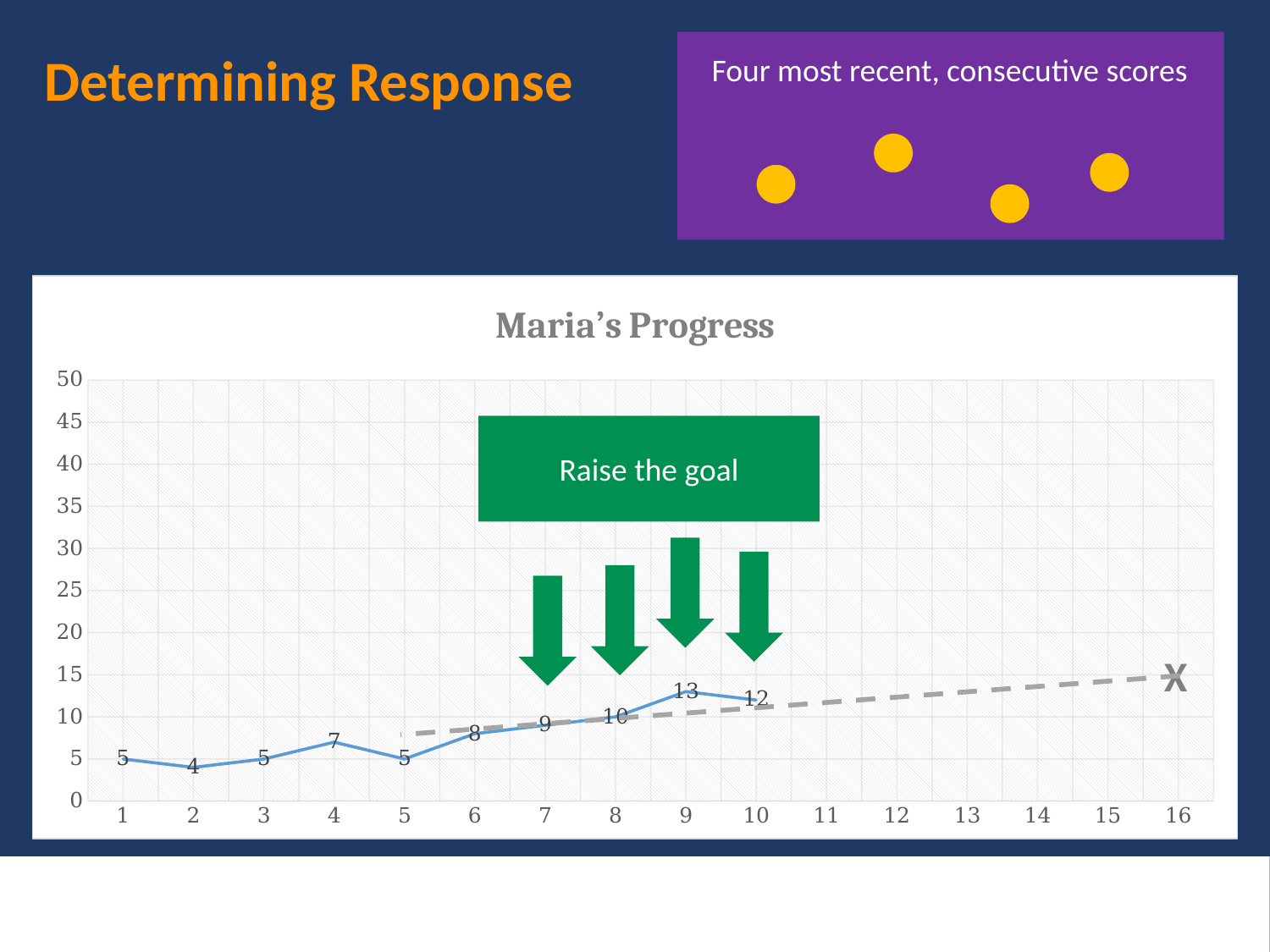
What is Maria's score at point 9? 13 Do Maria's scores generally rise or fall from point 5 to point 9? rise What is Maria's score at point 2? 4 At which point is Maria's score lowest? 2 Is Maria's score at point 8 greater or less than 15? less What is Maria's score at point 6? 8 At which point is Maria's score highest? 9 Which is larger, Maria's score at point 4 or at point 5? point 4 What is the difference between Maria's score at point 9 and her score at point 10? 1 How many data points with labelled scores are plotted on Maria's line? 10 What is the title of the chart? Maria's Progress What kind of chart is shown on the slide? line chart